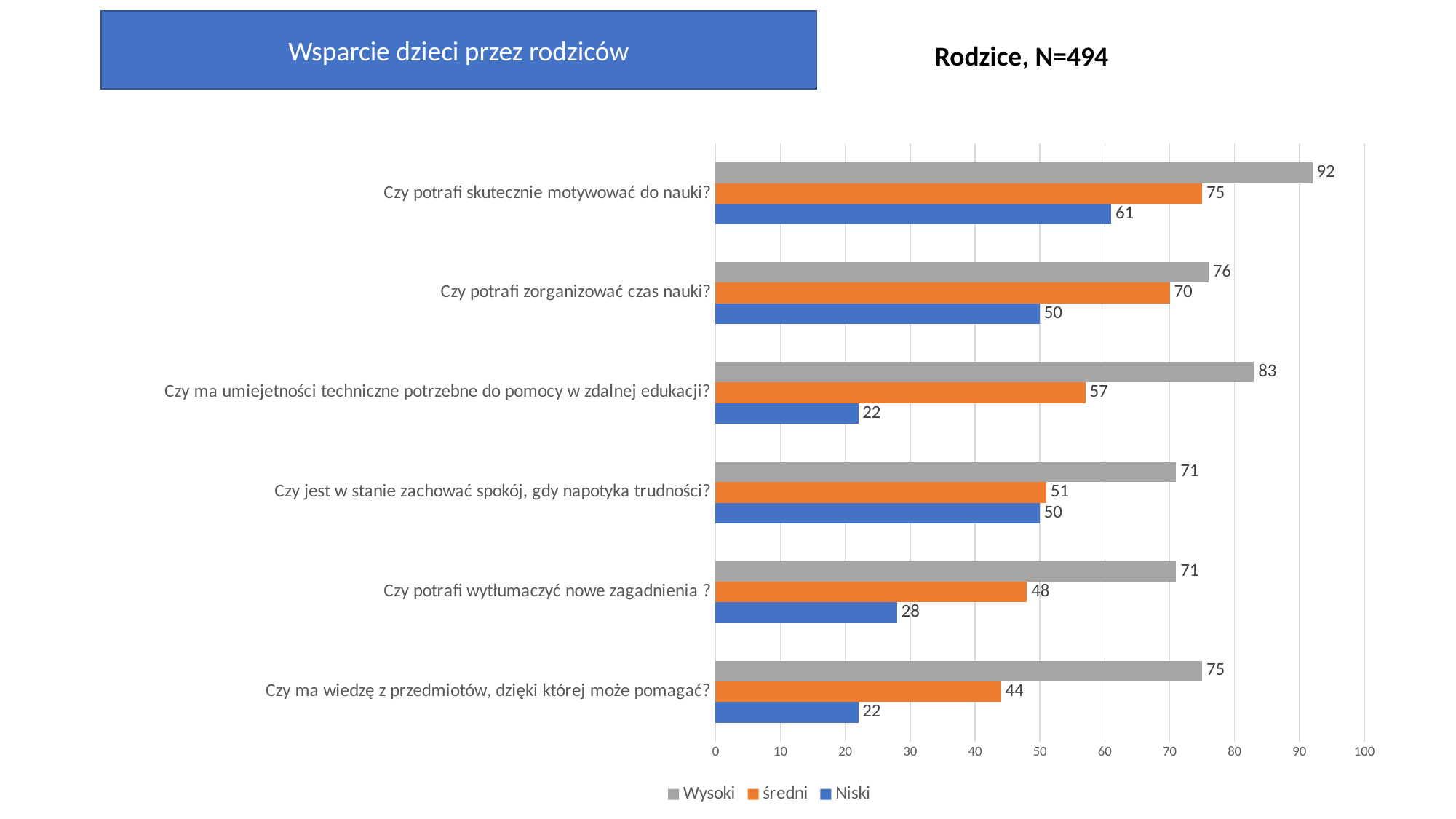
Which category has the lowest średni value? Czy ma wiedzę z przedmiotów, dzięki której może pomagać? What sample size is stated on the slide? N=494 Which category has the highest Wysoki value? Czy potrafi skutecznie motywować do nauki? How many series does the legend list? 3 What is the Niski value for "Czy ma umiejetności techniczne potrzebne do pomocy w zdalnej edukacji?"? 22 Which is larger for "Czy jest w stanie zachować spokój, gdy napotyka trudności?": the średni value or the Niski value? średni What is the Wysoki value for "Czy potrafi skutecznie motywować do nauki?"? 92 What kind of chart is shown on the slide? Bar chart What is the difference between the Wysoki and Niski values for "Czy potrafi zorganizować czas nauki?"? 26 What is the title shown in the blue box above the chart? Wsparcie dzieci przez rodziców What is the średni value for "Czy potrafi wytłumaczyć nowe zagadnienia ?"? 48 How many categories are shown on the chart? 6